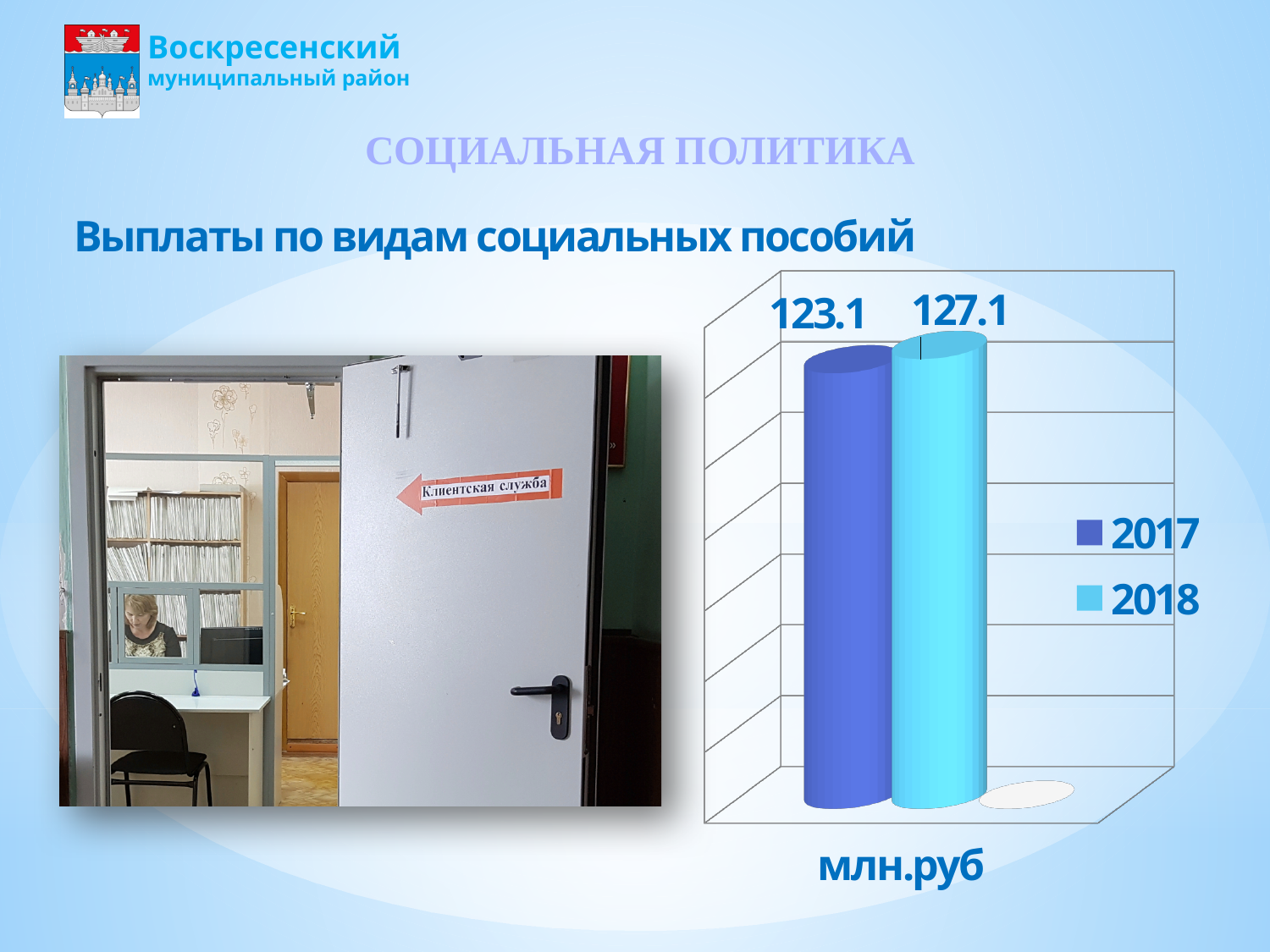
What is the value for 2018 on the chart? 127.1 How many bars are plotted on the chart? 2 What is the value for 2017 on the chart? 123.1 Which year has the lower value on the chart? 2017 Do the values rise or fall from 2017 to 2018? rise Which year has the higher value on the chart? 2018 What is the difference between the 2018 and 2017 values? 4.0 What kind of chart is shown on the slide? bar chart Is the value for 2018 larger or smaller than the value for 2017? larger How many series does the legend list? 2 Which series is shown in light blue in the legend? 2018 What unit is shown below the chart? млн.руб